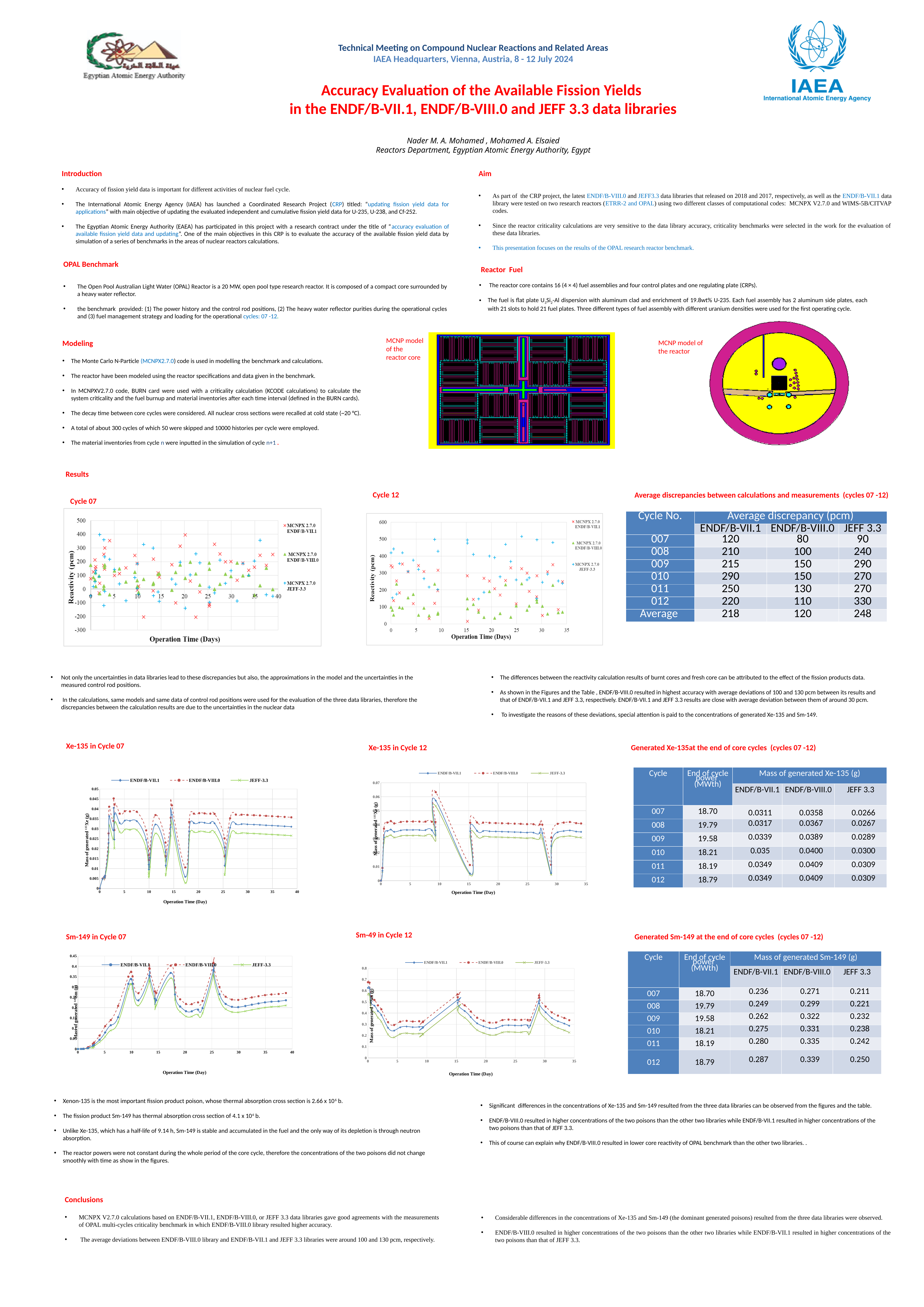
In the Xe-135 in Cycle 12 chart, which series has the highest values over most of the cycle? ENDF/B-VIII.0 How many series does the legend of the Cycle 07 reactivity chart list? 3 In the Sm-149 in Cycle 07 chart, is the ENDF/B-VIII.0 value at day 25 greater or less than 0.3? greater In the Sm-49 in Cycle 12 chart, do the values rise or fall between day 0 and day 5? fall What kind of chart is the Xe-135 in Cycle 07 chart? line chart What is the x-axis title of the Cycle 07 reactivity chart? Operation Time (Days) Which three series are listed in the legend of the Xe-135 in Cycle 07 chart? ENDF/B-VII.1, ENDF/B-VIII.0, JEFF-3.3 In the Sm-149 in Cycle 07 chart, which series has the lowest values over most of the cycle? JEFF-3.3 What kind of chart is the Cycle 07 reactivity chart? scatter chart How many series does the legend of the Sm-49 in Cycle 12 chart list? 3 In the Sm-149 in Cycle 07 chart, do the values rise or fall between day 0 and day 10? rise In the Xe-135 in Cycle 07 chart, is the ENDF/B-VIII.0 value at day 30 greater or less than 0.03? greater